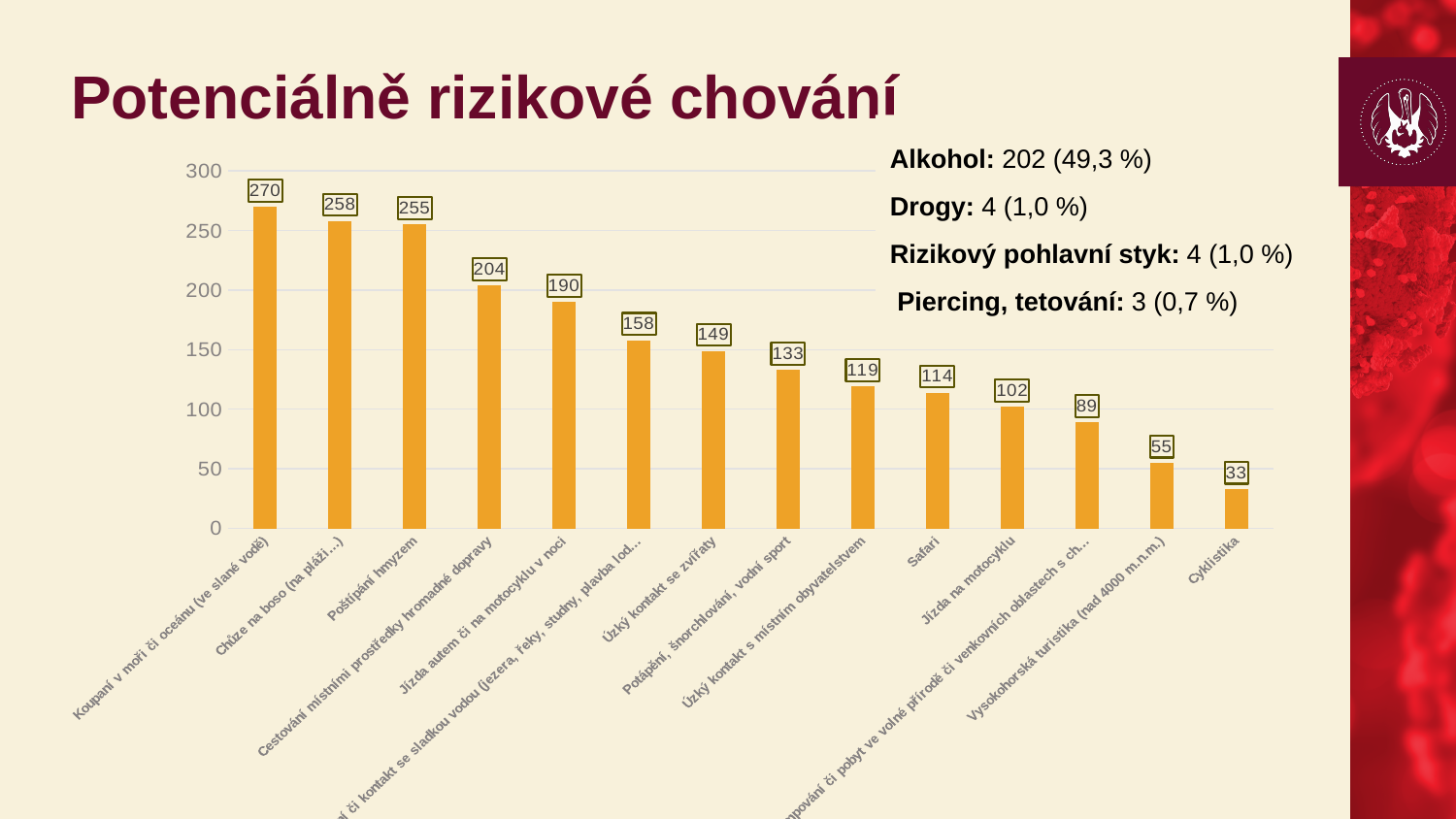
How many bars does the chart show? 14 Is the value for Potápění, šnorchlování, vodní sport greater or less than 150? less Which category has the highest value? Koupání v moři či oceánu (ve slané vodě) Which is larger, the value for Chůze na boso (na pláži...) or the value for Cestování místními prostředky hromadné dopravy? Chůze na boso (na pláži...) What value is shown for Poštípání hmyzem? 255 Do the values rise or fall from left to right along the x axis? fall What value is shown for Safari? 114 What is the difference between the values for Úzký kontakt se zvířaty and Vysokohorská turistika (nad 4000 m.n.m.)? 94 What value is shown for Cyklistika? 33 Which category has the lowest value? Cyklistika What value is shown for Jízda na motocyklu? 102 What kind of chart is shown on the slide? bar chart